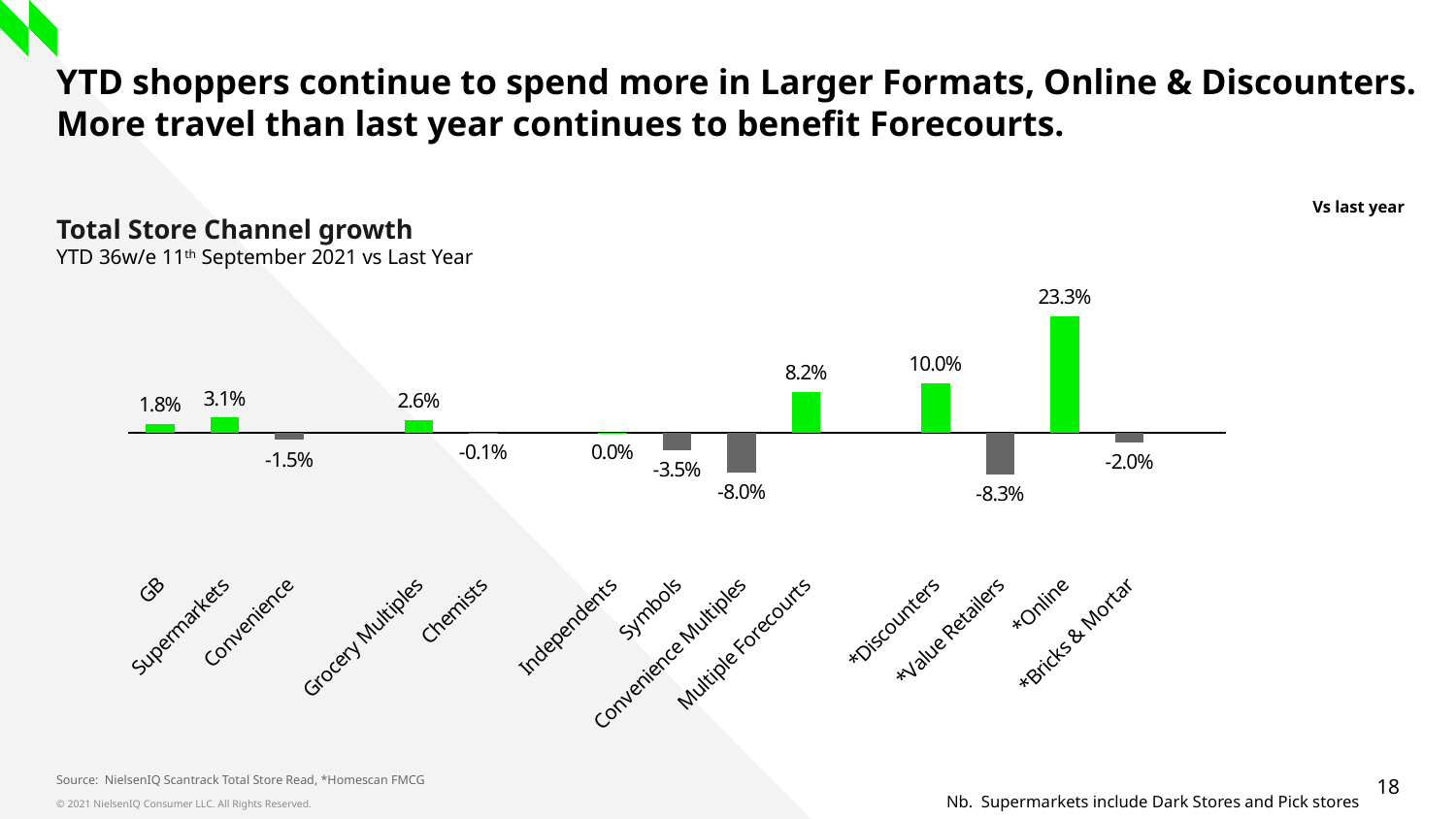
How many channels are shown in the chart? 13 What is the difference between the values for *Online and *Discounters? 13.3% Which channel has the lowest value? *Value Retailers What kind of chart is shown on the slide? Bar chart What is the value for Multiple Forecourts? 8.2% Which is larger, the value for Supermarkets or the value for Grocery Multiples? Supermarkets What is the value for Convenience Multiples? -8.0% Which channel has the highest growth? *Online What is the title of the chart? Total Store Channel growth What is the value for GB? 1.8% What is the value for *Online in the Total Store Channel growth chart? 23.3% What is the value for *Discounters? 10.0%